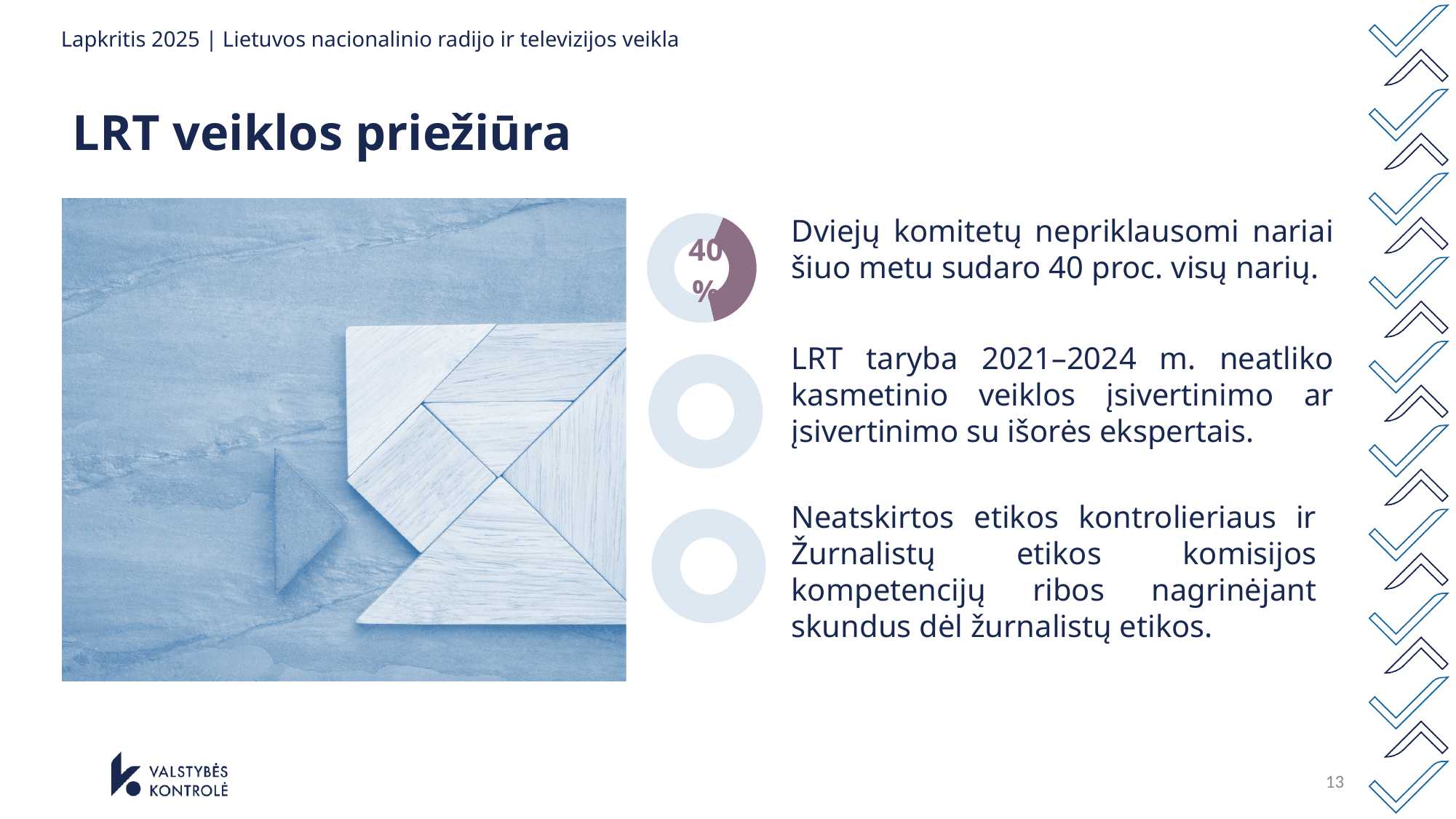
What value is printed on the doughnut chart next to the first bullet point? 40% How many slices does the doughnut chart next to the first bullet point have? 2 What kind of chart is shown next to the first bullet point on the slide? doughnut (pie) chart What share of the doughnut chart does the purple (highlighted) slice represent? 40% What share of the doughnut chart does the light blue (unhighlighted) slice represent? 60% Which slice of the doughnut chart is larger, the purple slice or the light blue slice? the light blue slice Is the value shown on the doughnut chart greater or less than 50%? less What colour is the slice labelled 40% in the doughnut chart? purple